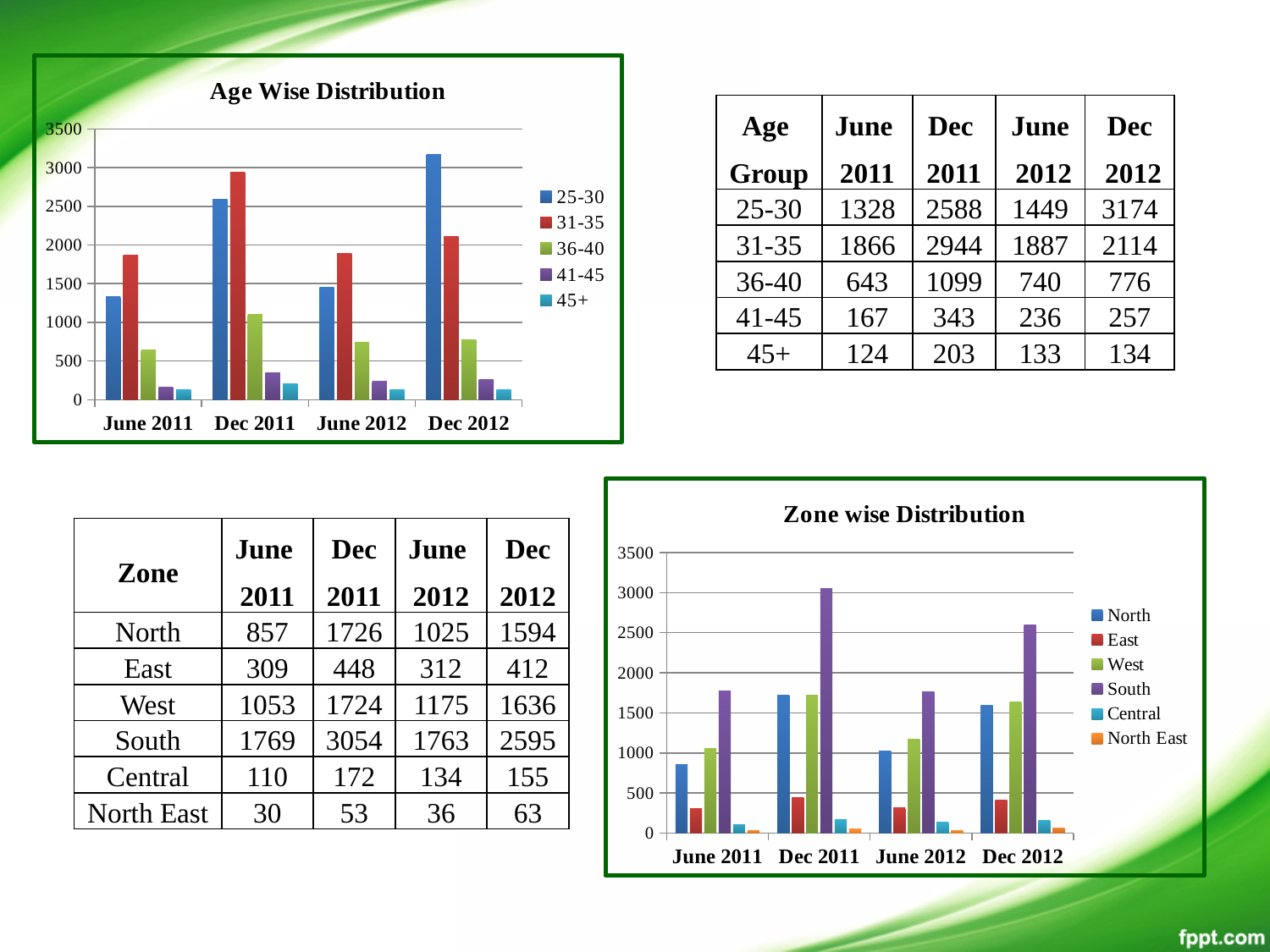
In the Zone wise Distribution chart, is the value for North in Dec 2011 larger or smaller than the value for West in Dec 2011? larger In the Age Wise Distribution chart, what is the value for the 36-40 age group in June 2011? 643 What kind of chart is the Zone wise Distribution chart? Bar chart In the Age Wise Distribution chart, what is the difference between the 31-35 and 25-30 values in June 2011? 538 In the Zone wise Distribution chart, which zone has the lowest value in Dec 2012? North East In the Age Wise Distribution chart, how many series does the legend list? 5 In the Zone wise Distribution chart, is the value for South in June 2012 greater or less than 1500? greater In the Age Wise Distribution chart, which age group has the lowest value in June 2012? 45+ In the Zone wise Distribution chart, what is the value for South in Dec 2011? 3054 In the Age Wise Distribution chart, what is the value for the 25-30 age group in Dec 2012? 3174 In the Age Wise Distribution chart, which age group has the highest value in Dec 2011? 31-35 In the Zone wise Distribution chart, how many periods are shown on the x axis? 4